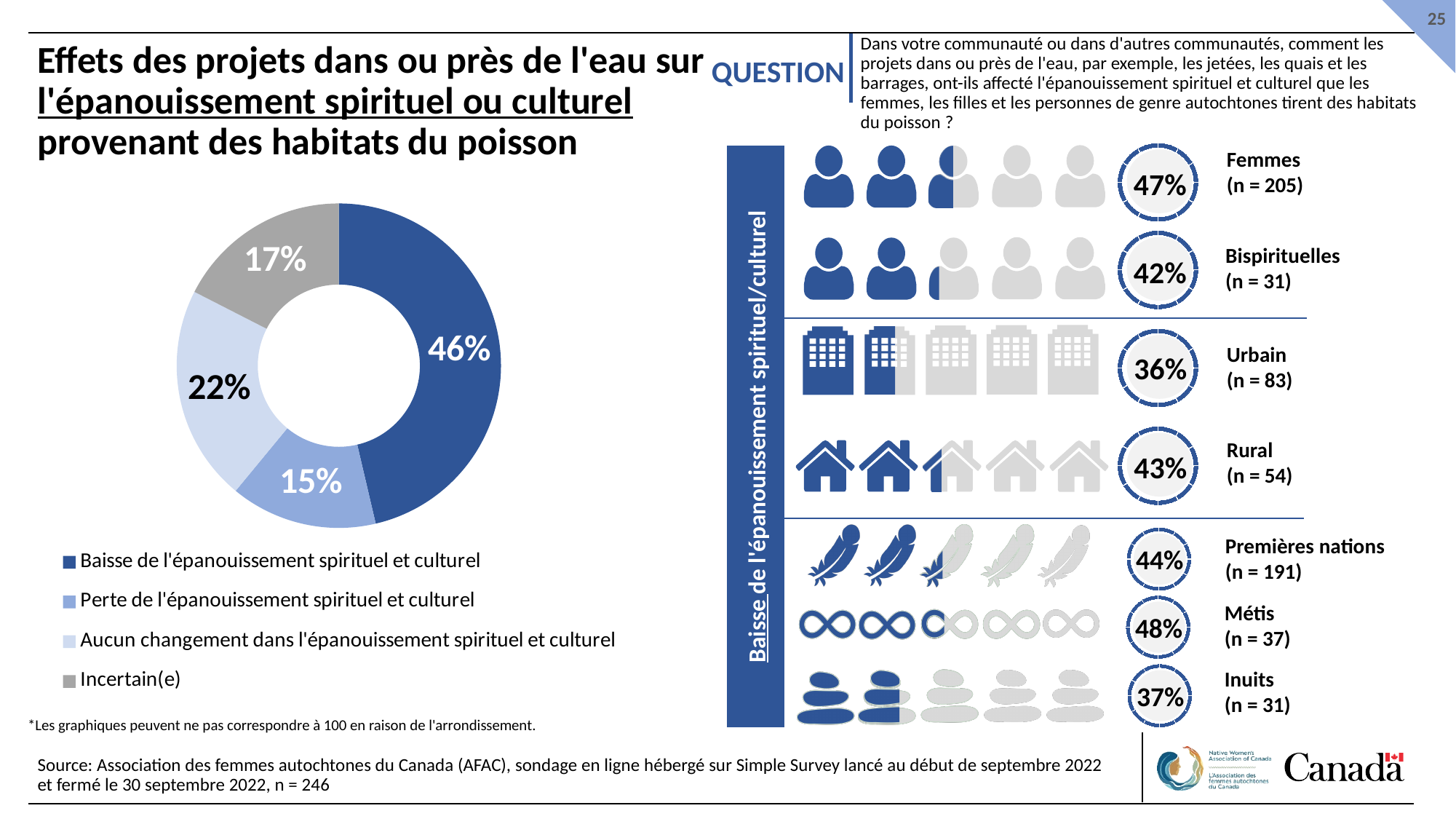
In the donut chart on the left, which category has the smallest share? Perte de l'épanouissement spirituel et culturel How many categories does the legend of the donut chart on the left list? 4 In the donut chart on the left, what percentage is shown for "Perte de l'épanouissement spirituel et culturel"? 15% In the pictograph on the right, which group has the highest percentage: Urbain or Rural? Rural In the donut chart on the left, which category has the largest share? Baisse de l'épanouissement spirituel et culturel In the donut chart on the left, what percentage is shown for "Aucun changement dans l'épanouissement spirituel et culturel"? 22% What kind of chart is shown on the left side of the slide? Donut (pie) chart In the donut chart on the left, what percentage is shown for "Incertain(e)"? 17% In the donut chart on the left, what is the difference in percentage points between "Baisse" (46%) and "Aucun changement" (22%)? 24 percentage points In the donut chart on the left, what percentage is shown for "Baisse de l'épanouissement spirituel et culturel"? 46% In the pictograph on the right, what percentage is shown for "Femmes (n = 205)"? 47% In the pictograph on the right, which of the listed groups has the lowest percentage? Urbain